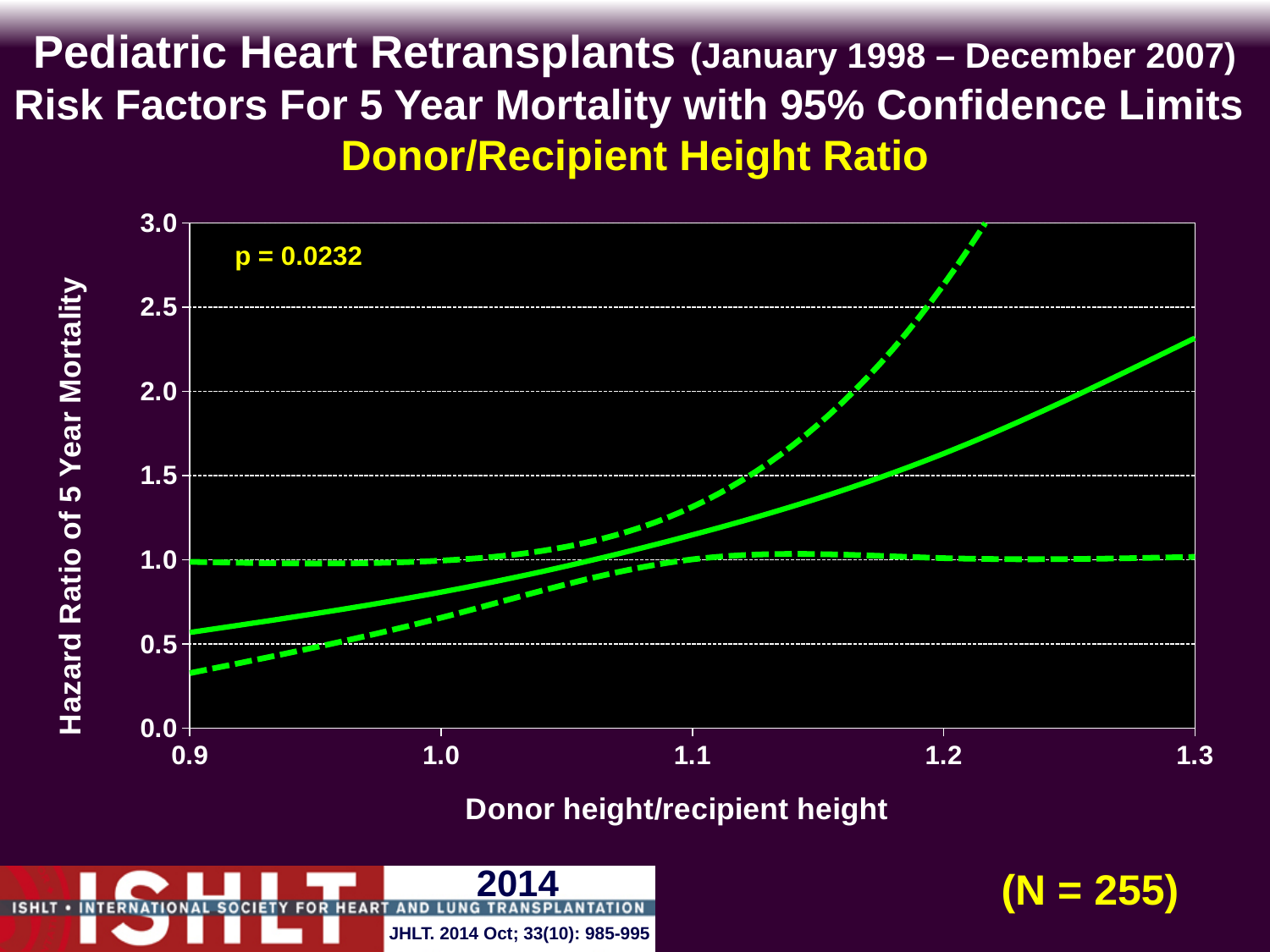
Is the upper 95% confidence limit (upper dashed line) at a donor height/recipient height ratio of 1.1 greater or less than 1.5? less Is the upper 95% confidence limit (upper dashed line) at a donor height/recipient height ratio of 1.2 greater or less than 2.0? greater How many lines are plotted on the chart? 3 Does the solid hazard ratio line rise or fall as the donor height/recipient height ratio increases from 0.9 to 1.3? rise Is the hazard ratio (solid line) at a donor height/recipient height ratio of 1.3 greater or less than 2.0? greater What p-value is shown on the chart? p = 0.0232 What sample size (N) is shown on the slide? N = 255 What kind of chart is shown on the slide? line chart